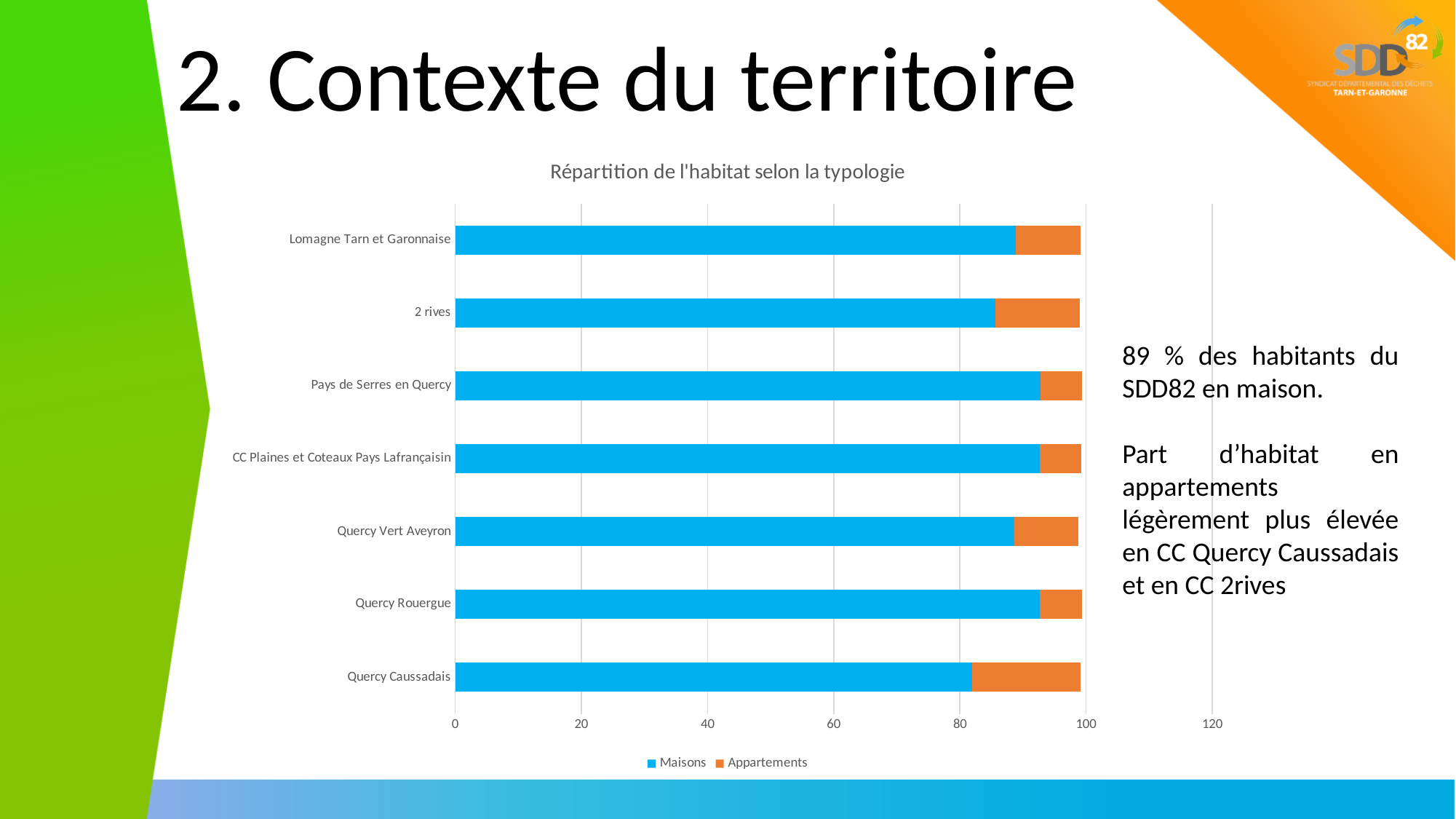
Which category has the highest value for Appartements? Quercy Caussadais Which series are listed in the legend? Maisons, Appartements Which is larger, the Appartements value for Quercy Caussadais or for Quercy Rouergue? Quercy Caussadais Is the Maisons value for 2 rives greater or less than 100? less What is the title of the chart? Répartition de l'habitat selon la typologie How many series does the legend list? 2 Is the Appartements value for Quercy Caussadais greater or less than 20? less Which is larger, the Maisons value for Pays de Serres en Quercy or for Quercy Caussadais? Pays de Serres en Quercy Which category has the lowest value for Maisons? Quercy Caussadais What kind of chart is shown on the slide? bar chart How many categories (territories) are shown on the chart? 7 Is the Maisons value for Lomagne Tarn et Garonnaise greater or less than 80? greater